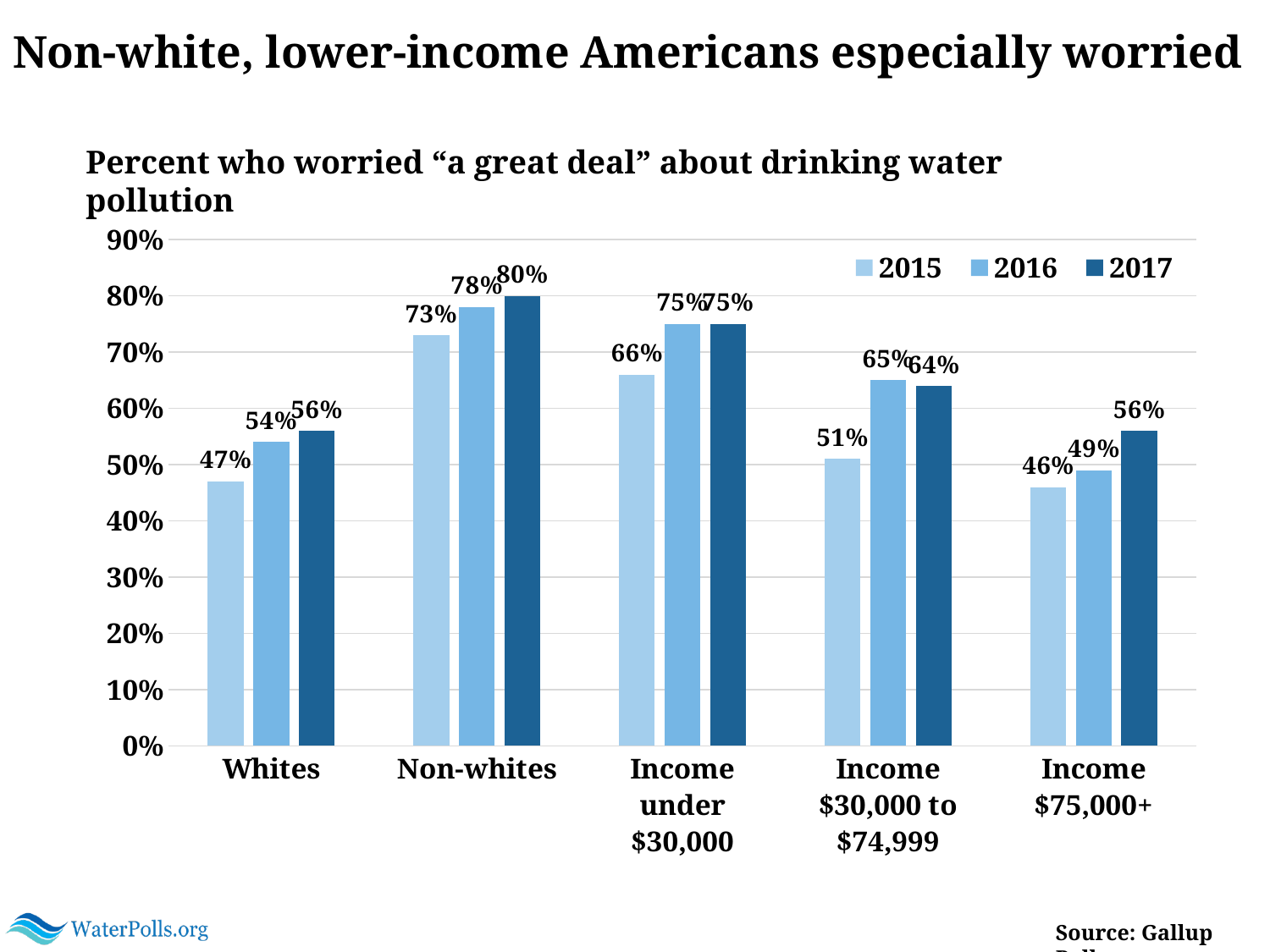
Do the values for Whites rise or fall from 2015 to 2017? Rise How many categories are shown on the x axis? 5 What is the difference between the 2017 values for Non-whites and Whites? 24% What percentage of Whites worried a great deal about drinking water pollution in 2015? 47% Which is larger: the 2016 value for Income under $30,000 or the 2016 value for Income $75,000+? Income under $30,000 Which category has the lowest value in 2015? Income $75,000+ Which years are listed in the legend? 2015, 2016, 2017 What is the 2017 value for Non-whites? 80% How many series does the legend list? 3 What is the 2016 value for Income $30,000 to $74,999? 65% Which category has the highest value in 2017? Non-whites What kind of chart is shown on the slide? Bar chart